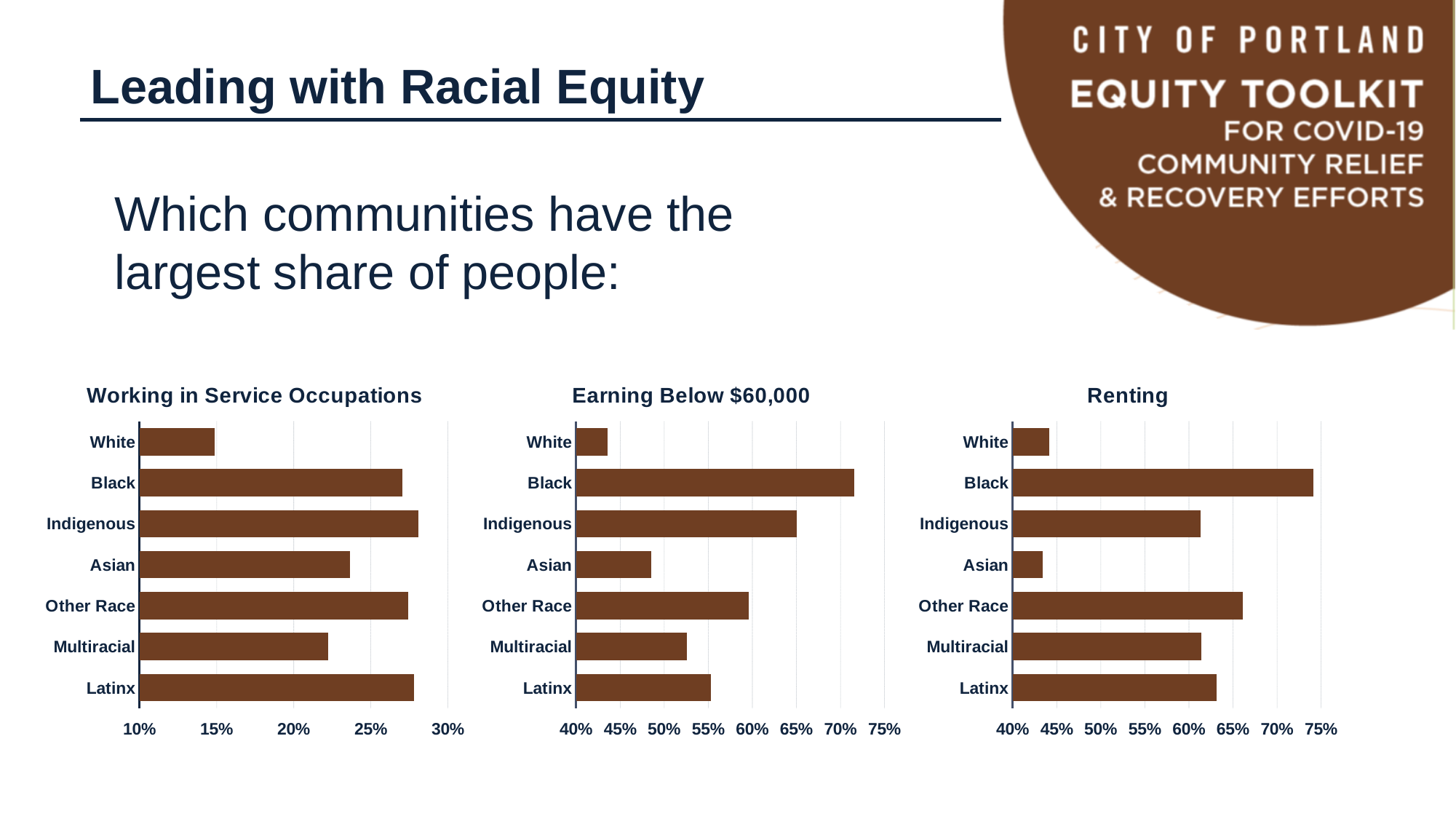
In the 'Working in Service Occupations' chart, which community has the lowest value? White In the 'Earning Below $60,000' chart, is the value for Black greater or less than 70%? greater In the 'Working in Service Occupations' chart, is the value for White greater or less than 20%? less In the 'Earning Below $60,000' chart, is the value for Indigenous greater or less than 60%? greater What kind of chart is the 'Renting' chart? Bar chart In the 'Renting' chart, which is larger, the value for Other Race or the value for White? Other Race In the 'Renting' chart, which community has the highest value? Black In the 'Earning Below $60,000' chart, which is larger, the value for Black or the value for Indigenous? Black How many communities are shown in the 'Working in Service Occupations' chart? 7 In the 'Earning Below $60,000' chart, which community has the highest value? Black In the 'Earning Below $60,000' chart, which community has the lowest value? White